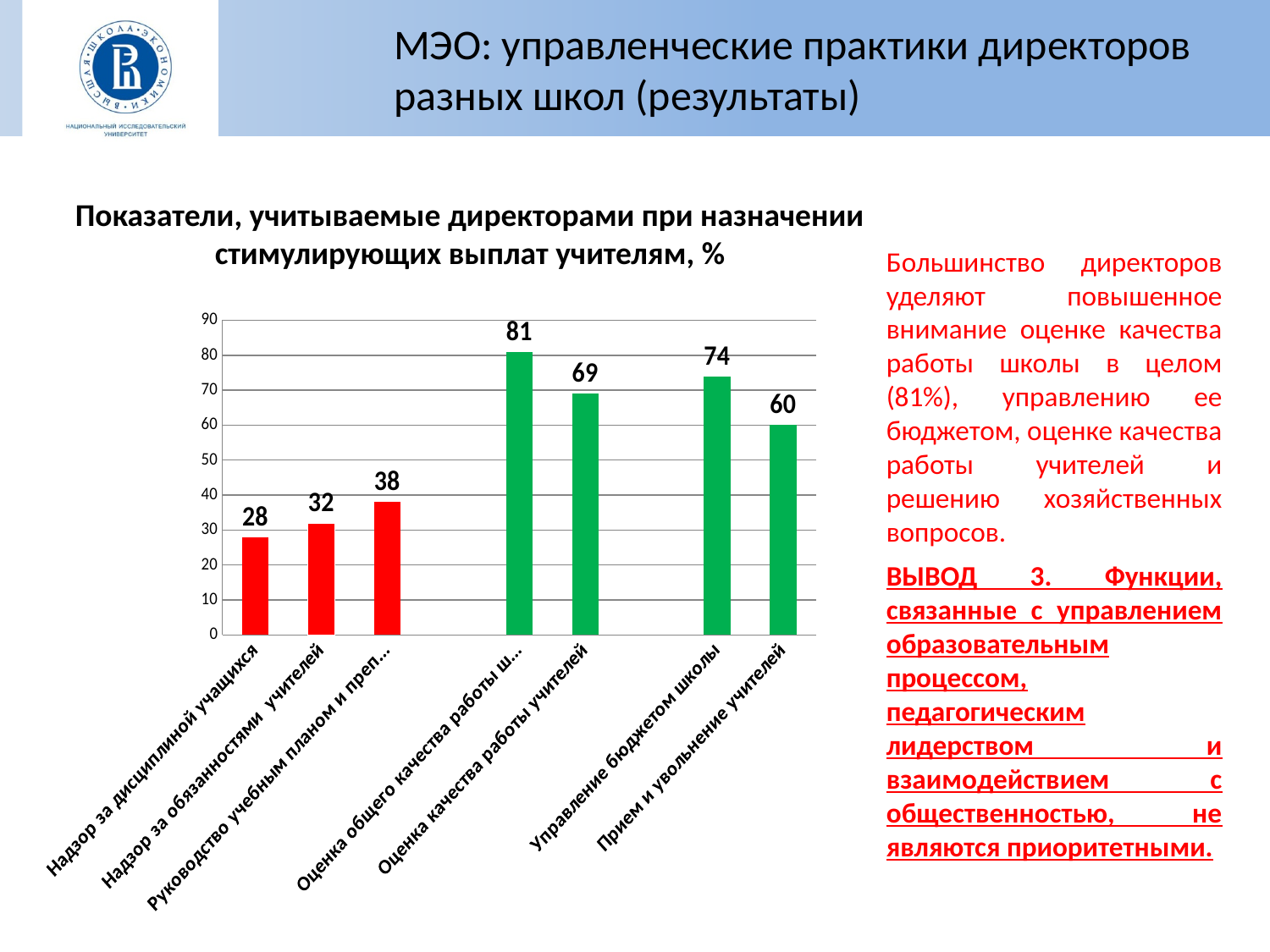
What is the difference between the values for «Управление бюджетом школы» and «Прием и увольнение учителей»? 14 How many bars on the chart are coloured red? 3 How many bars are shown on the chart? 7 Is the value for «Прием и увольнение учителей» greater or less than 50? greater What value is shown for «Прием и увольнение учителей»? 60 What type of chart is shown on the slide? bar chart What value is shown for «Оценка качества работы учителей»? 69 Which is larger: the value for «Надзор за обязанностями учителей» or for «Оценка качества работы учителей»? Оценка качества работы учителей What is the highest value shown on the chart? 81 Which category has the lowest value? Надзор за дисциплиной учащихся What value is shown for «Надзор за дисциплиной учащихся»? 28 What value is shown for «Управление бюджетом школы»? 74